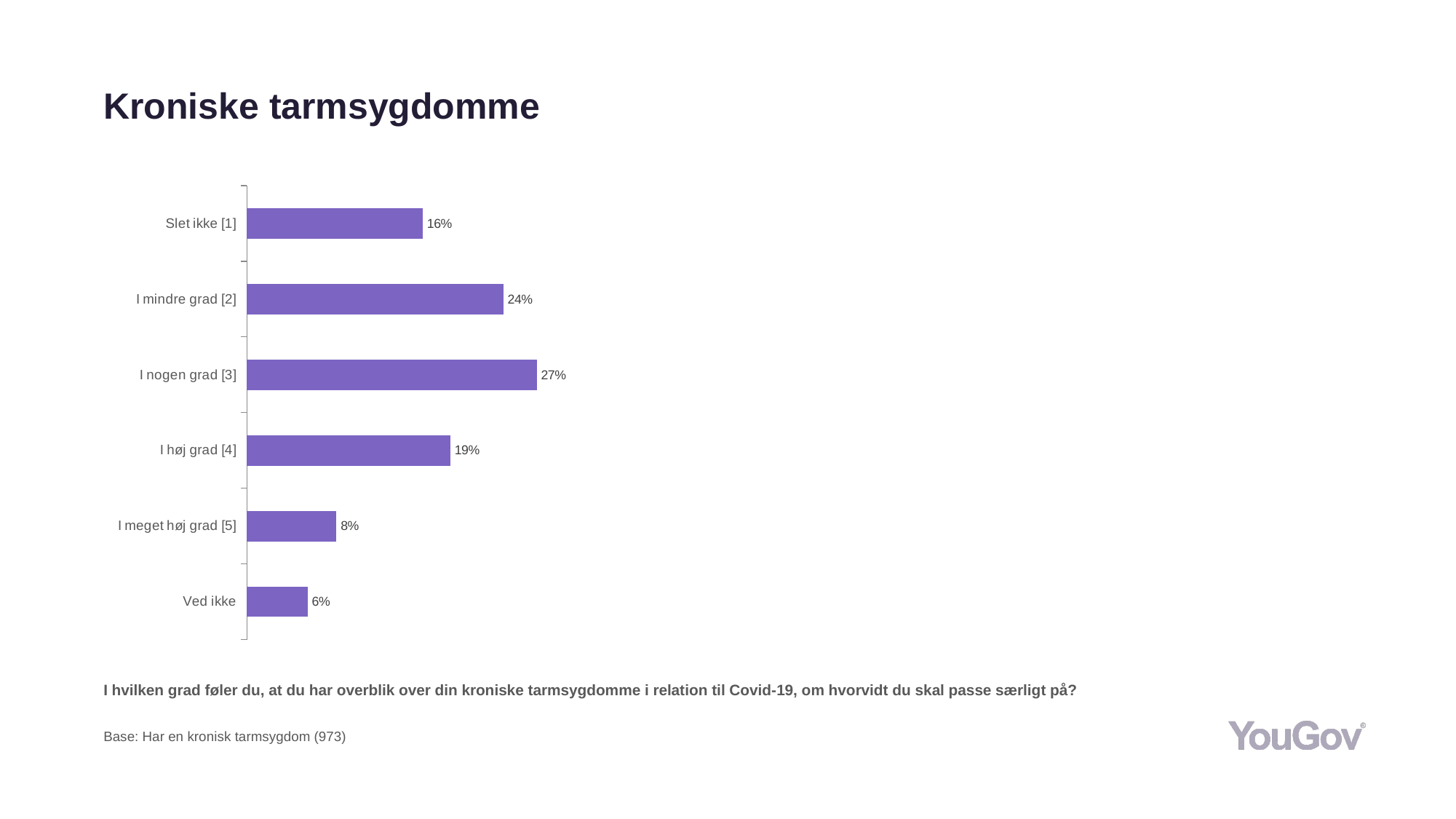
How many categories are shown in the chart? 6 What is the value for "I nogen grad [3]"? 27% What is the title of the slide? Kroniske tarmsygdomme What is the difference between "I nogen grad [3]" and "Slet ikke [1]"? 11% Which category has the highest value? I nogen grad [3] Which category has the lowest value? Ved ikke What kind of chart is shown on the slide? Bar chart What is the value for "I meget høj grad [5]"? 8% What is the value for "Ved ikke"? 6% What is the difference between "I mindre grad [2]" and "I høj grad [4]"? 5% What is the value for "Slet ikke [1]"? 16% Which is larger, "I mindre grad [2]" or "I høj grad [4]"? I mindre grad [2]